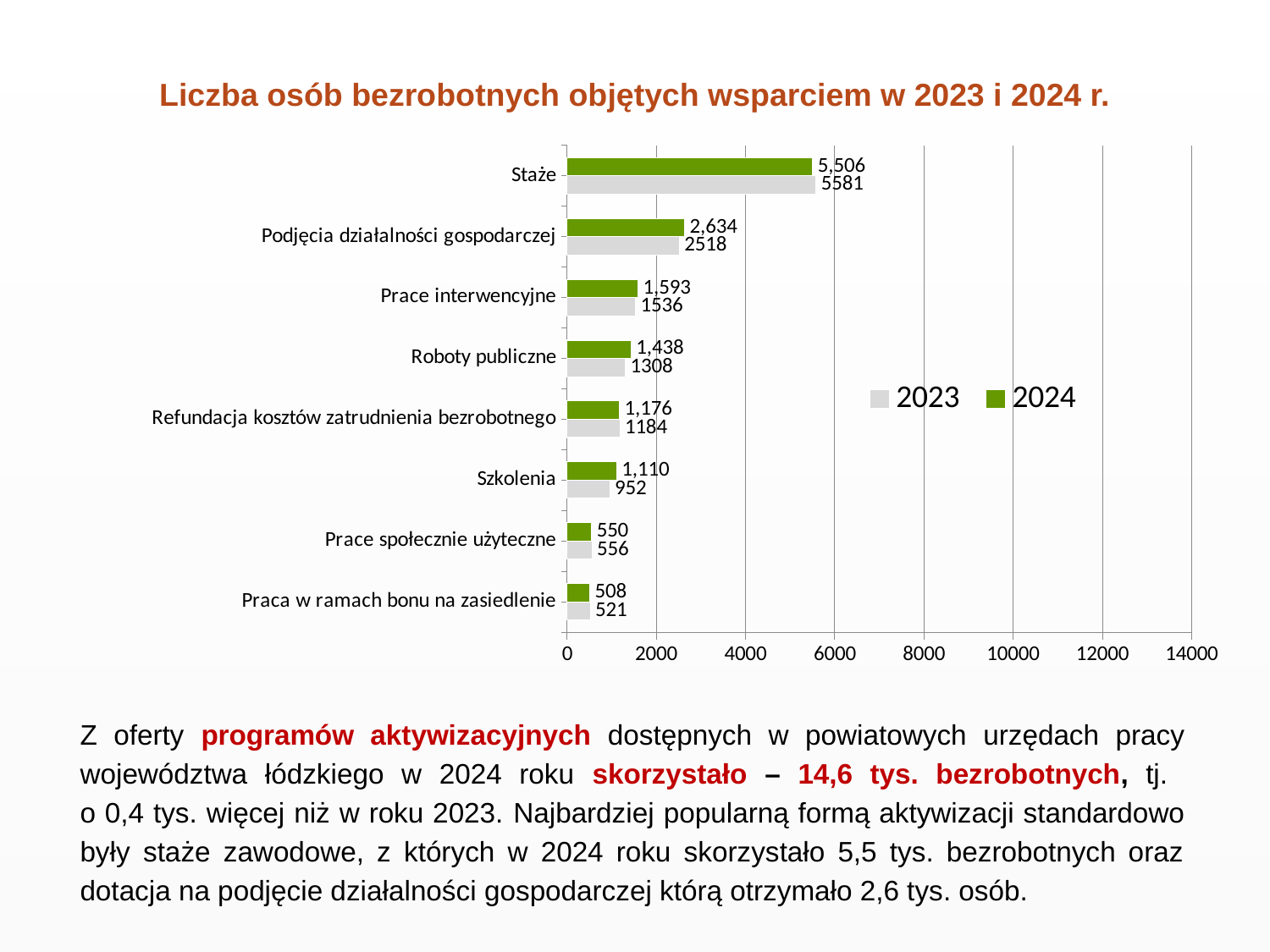
For Refundacja kosztów zatrudnienia bezrobotnego, which year has the larger value, 2023 or 2024? 2023 Is the 2024 value for Podjęcia działalności gospodarczej greater or less than 2000? greater What is the difference between the 2024 and 2023 values for Szkolenia? 158 What is the 2024 value for Roboty publiczne? 1,438 What is the 2023 value for Szkolenia? 952 How many categories are shown on the chart? 8 Which category has the lowest 2023 value? Praca w ramach bonu na zasiedlenie Which category has the highest 2024 value? Staże What is the 2024 value for Staże? 5,506 What is the difference between the 2023 and 2024 values for Staże? 75 What type of chart is shown on the slide? bar chart How many series does the legend list? 2